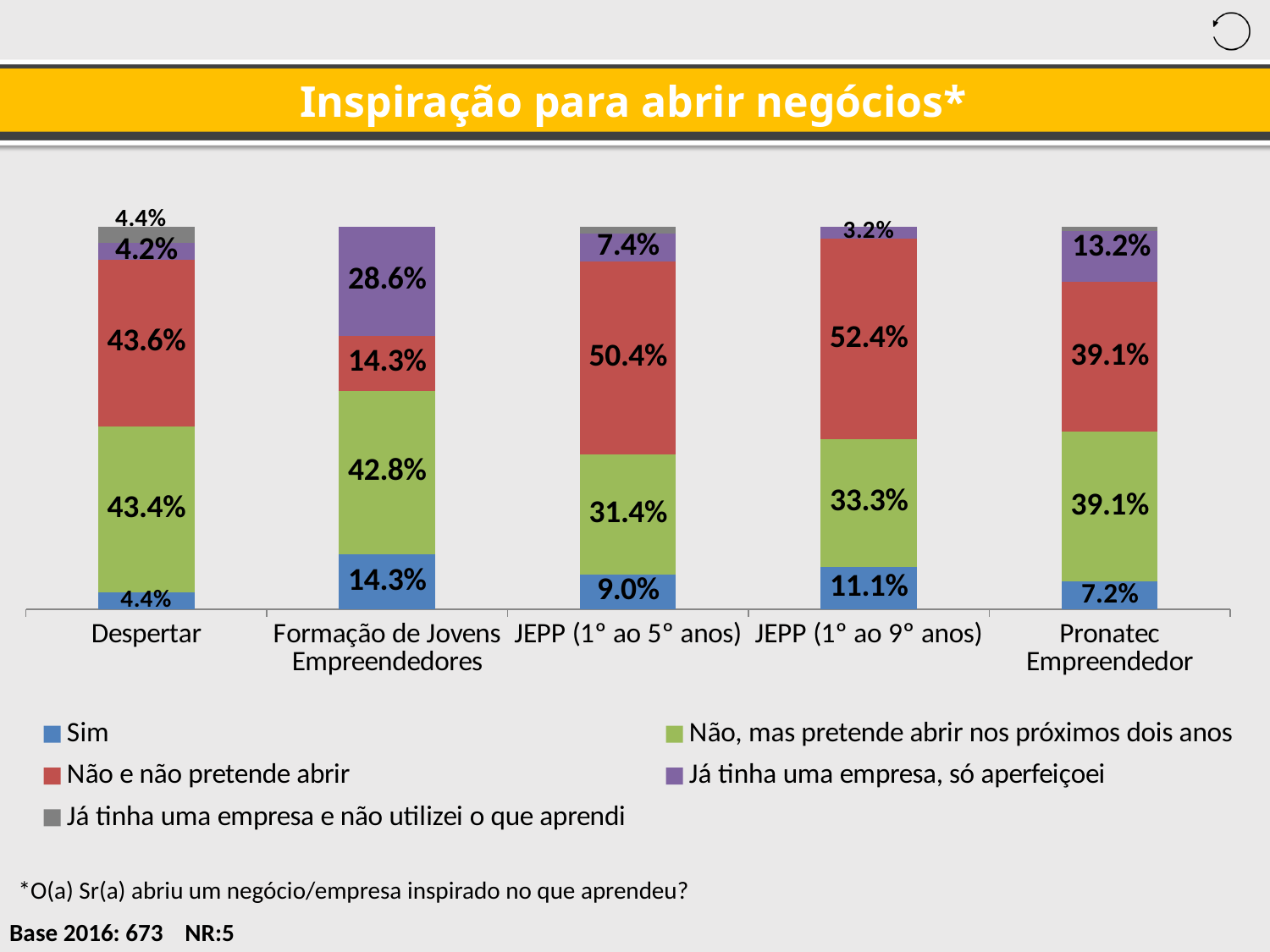
What is the value of "Não e não pretende abrir" for JEPP (1° ao 9° anos)? 52.4% Which is larger: the "Já tinha uma empresa, só aperfeiçoei" value for Formação de Jovens Empreendedores or for JEPP (1° ao 5° anos)? Formação de Jovens Empreendedores How many series does the legend list? 5 Which program has the lowest value for "Sim"? Despertar What is the value of "Sim" for Formação de Jovens Empreendedores? 14.3% What is the title of the chart? Inspiração para abrir negócios* What kind of chart is shown on the slide? stacked bar chart What is the value of "Não, mas pretende abrir nos próximos dois anos" for Despertar? 43.4% How many programs (categories) are shown on the x axis? 5 Which program has the highest value for "Sim"? Formação de Jovens Empreendedores What is the value of "Já tinha uma empresa, só aperfeiçoei" for Pronatec Empreendedor? 13.2% What is the difference between the "Não e não pretende abrir" values for JEPP (1° ao 5° anos) and Pronatec Empreendedor? 11.3%